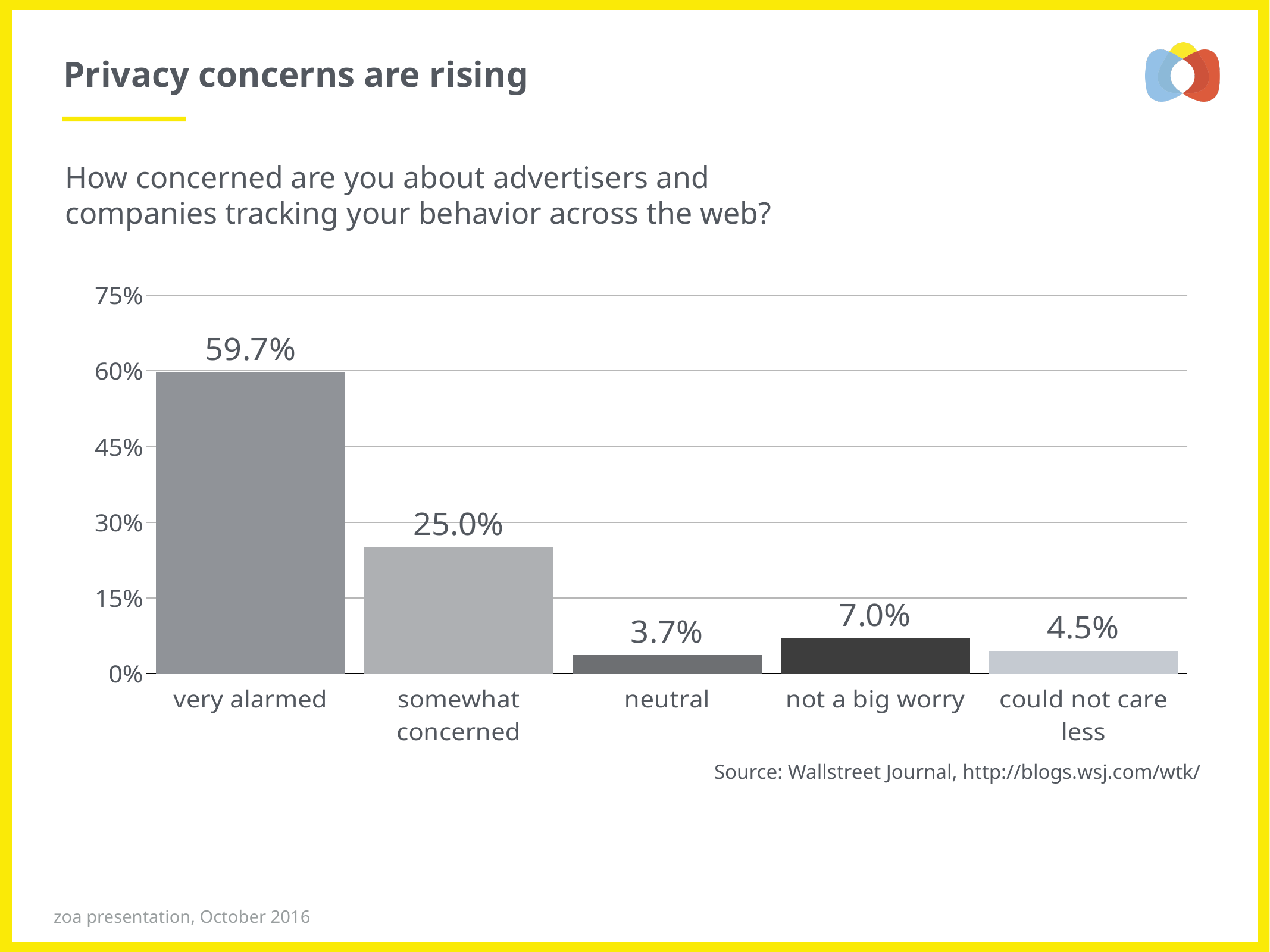
How many categories are shown on the chart? 5 Which category has the highest value? very alarmed Which is larger, not a big worry or could not care less? not a big worry What kind of chart is shown on the slide? bar chart What percentage of respondents are very alarmed? 59.7% What is the source cited for the chart? Wallstreet Journal, http://blogs.wsj.com/wtk/ What is the value for could not care less? 4.5% What is the value for neutral? 3.7% Which category has the lowest value? neutral What is the difference between very alarmed and somewhat concerned? 34.7% What is the value for somewhat concerned? 25.0% What is the value for not a big worry? 7.0%